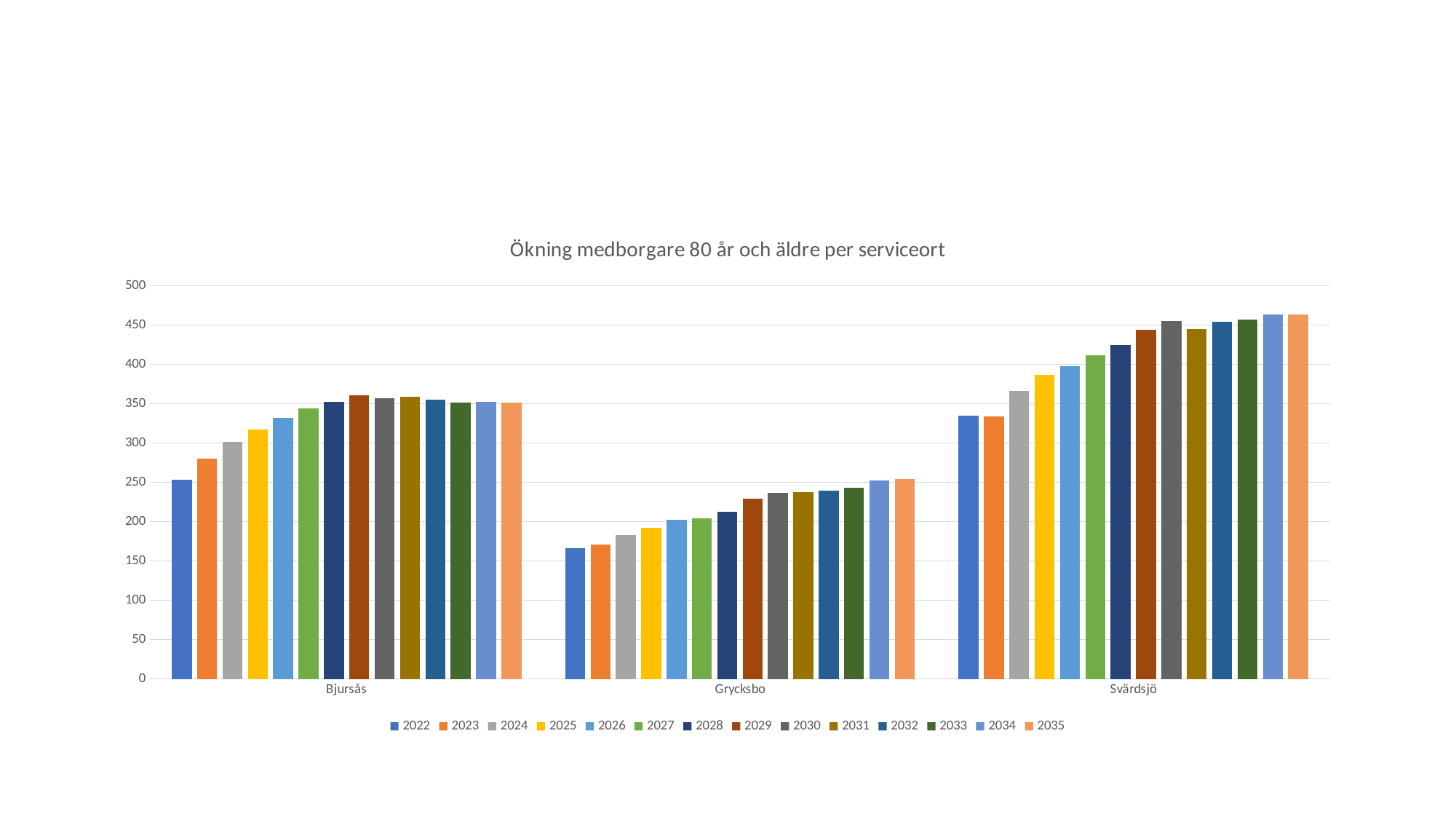
Do the values for Grycksbo rise or fall from 2022 to 2035? rise Which is larger: the value for Svärdsjö in 2022 or the value for Bjursås in 2022? Svärdsjö in 2022 How many series (years) does the legend list? 14 What is the title of the chart? Ökning medborgare 80 år och äldre per serviceort Which service location has the highest value for 2035? Svärdsjö How many service locations (categories) are shown on the x axis? 3 Is the value for Bjursås in 2022 greater or less than 300? less Is the value for Svärdsjö in 2035 greater or less than 400? greater What kind of chart is shown on the slide? bar chart Which service location has the lowest value for 2022? Grycksbo Is the value for Svärdsjö in 2022 greater or less than 300? greater